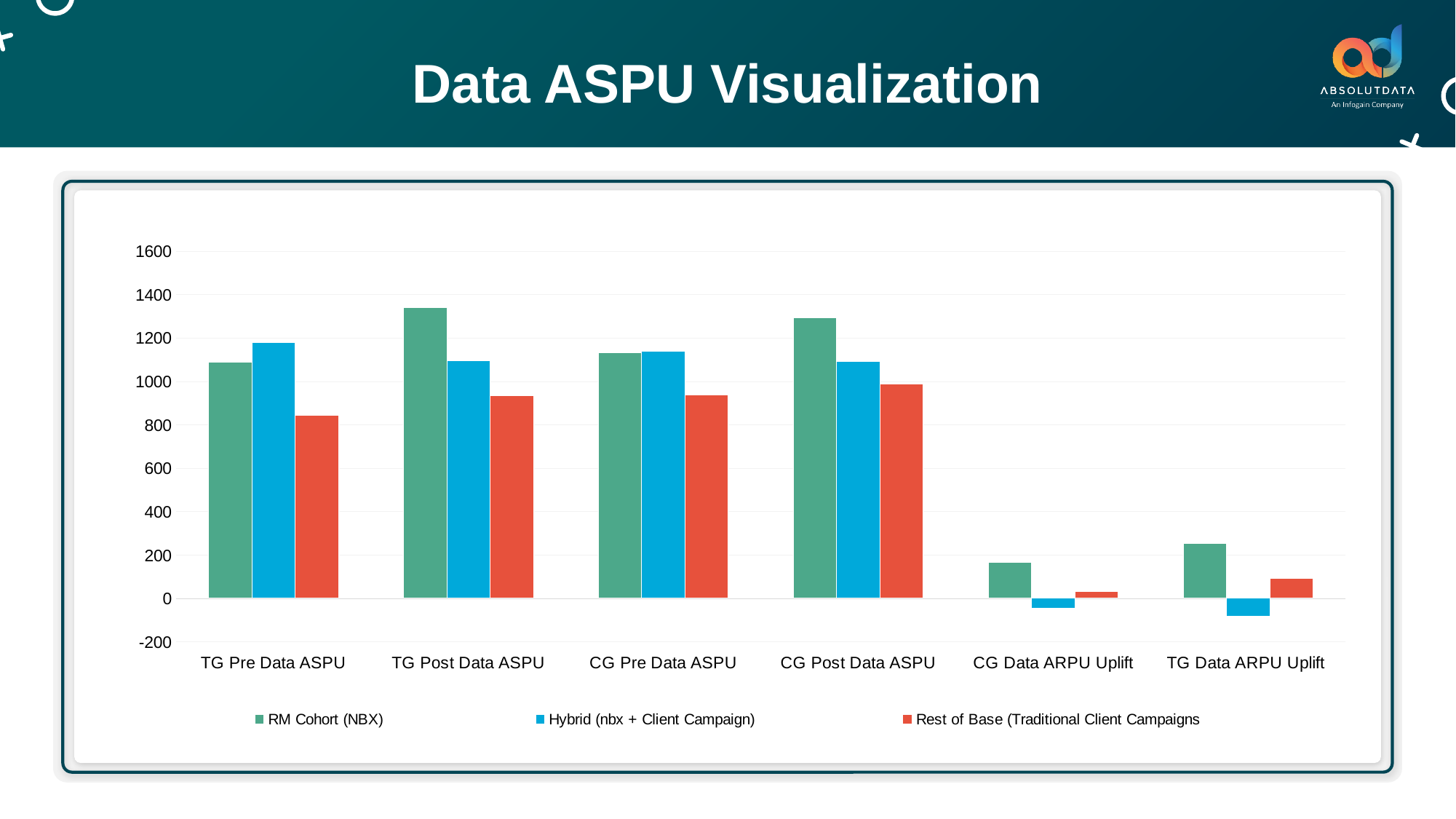
What kind of chart is shown on the slide? Bar chart For TG Pre Data ASPU, which is larger: the RM Cohort (NBX) bar or the Hybrid (nbx + Client Campaign) bar? Hybrid (nbx + Client Campaign) Which category has the highest RM Cohort (NBX) bar? TG Post Data ASPU How many series does the chart's legend list? 3 For CG Post Data ASPU, which is larger: the RM Cohort (NBX) bar or the Rest of Base (Traditional Client Campaigns) bar? RM Cohort (NBX) Which category has the lowest Hybrid (nbx + Client Campaign) bar? TG Data ARPU Uplift What colour represents the Rest of Base (Traditional Client Campaigns) series in the chart? Red How many categories are shown along the x axis of the chart? 6 Is the Rest of Base (Traditional Client Campaigns) value for TG Pre Data ASPU greater or less than 1000? less What is the title of the slide? Data ASPU Visualization Is the Hybrid (nbx + Client Campaign) value for CG Data ARPU Uplift greater or less than 0? less Is the RM Cohort (NBX) value for TG Post Data ASPU greater or less than 1200? greater